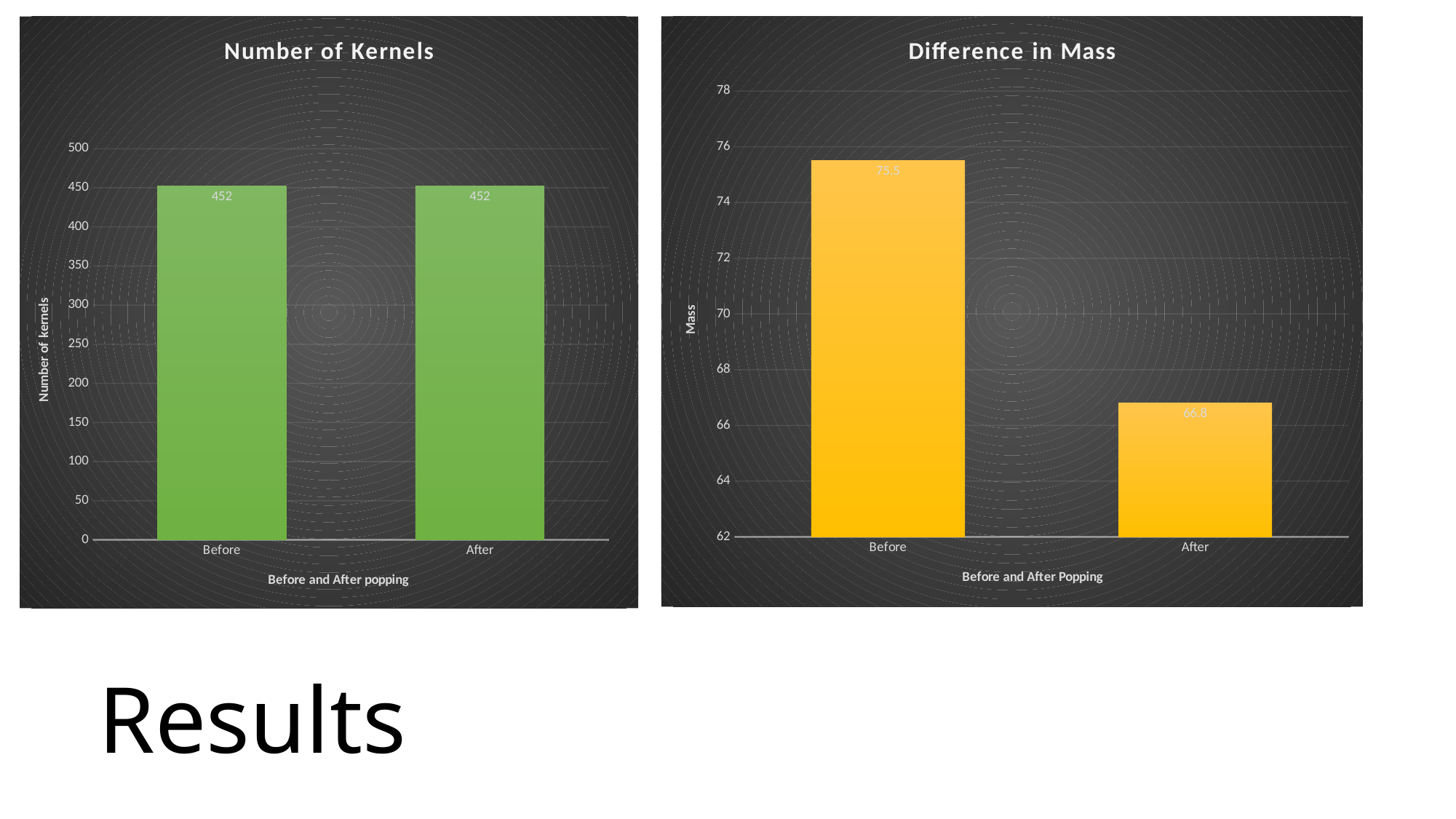
What is the y-axis label of the "Number of Kernels" chart? Number of kernels In the "Difference in Mass" chart, what is the value for Before? 75.5 In the "Difference in Mass" chart, is the value for After greater or less than 70? less In the "Difference in Mass" chart, what is the difference between the Before and After values? 8.7 In the "Difference in Mass" chart, which category has the highest value? Before In the "Number of Kernels" chart, what is the value for Before? 452 In the "Difference in Mass" chart, which category has the lowest value? After In the "Number of Kernels" chart, how many categories are shown? 2 In the "Number of Kernels" chart, what is the value for After? 452 What kind of chart is the "Difference in Mass" chart? bar chart In the "Difference in Mass" chart, what is the value for After? 66.8 In the "Difference in Mass" chart, do the values rise or fall from Before to After? fall